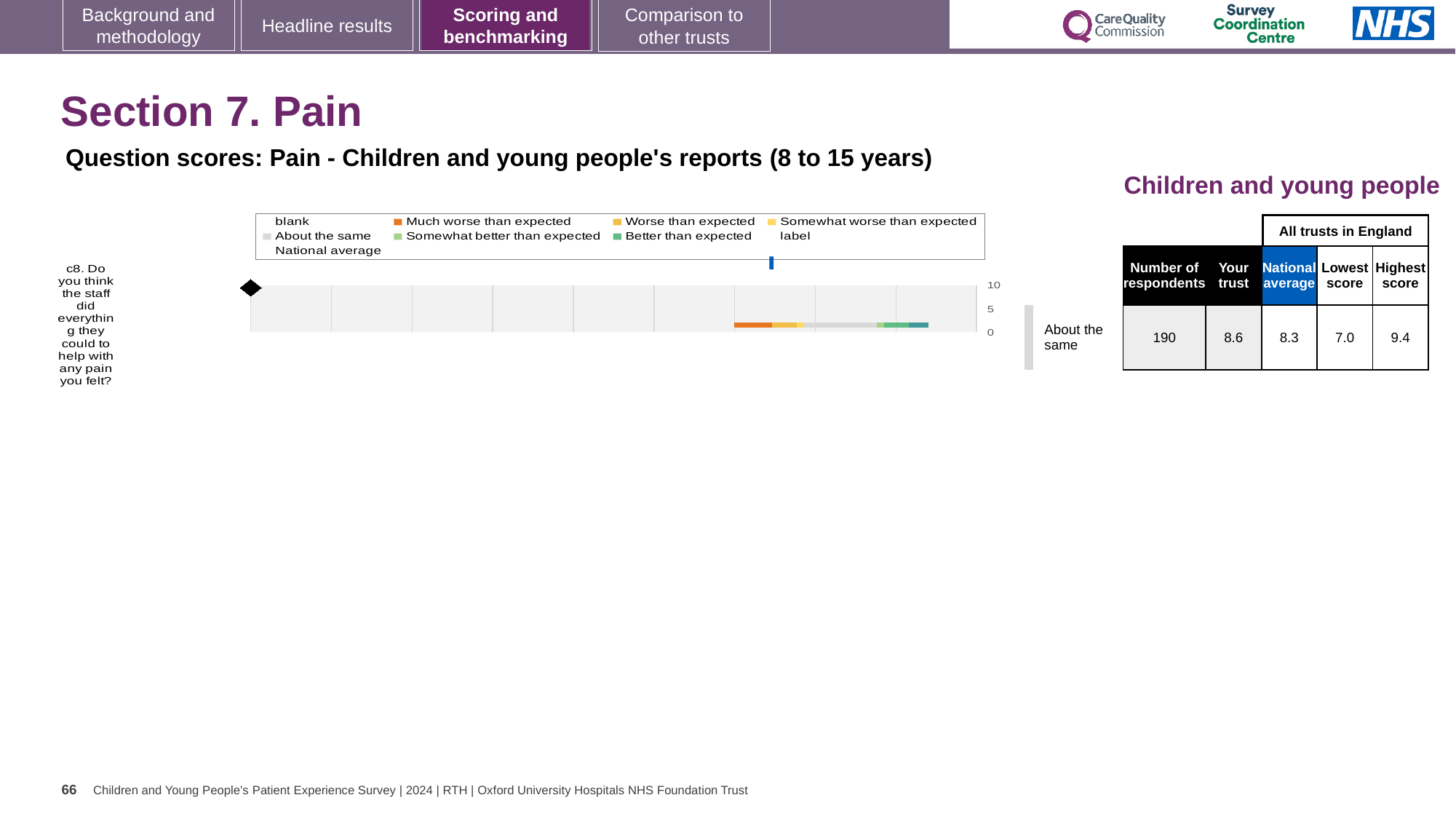
Which legend entry is shown in orange on the chart? Much worse than expected What is the difference between the highest score and the lowest score for question c8 in the table beside the chart? 2.4 What is the highest tick value shown on the chart's axis? 10 According to the table beside the chart, what is the lowest score among all trusts in England for question c8? 7.0 How many survey questions are plotted on the chart? 1 According to the table beside the chart, what is the national average score for question c8? 8.3 According to the table beside the chart, what is the 'Your trust' score for question c8? 8.6 What is the question code of the item plotted on the chart? c8 According to the table beside the chart, what is the highest score among all trusts in England for question c8? 9.4 Which is larger for question c8, the 'Your trust' score or the national average? Your trust What kind of chart is shown on the slide? bar chart According to the table beside the chart, how many respondents answered question c8? 190